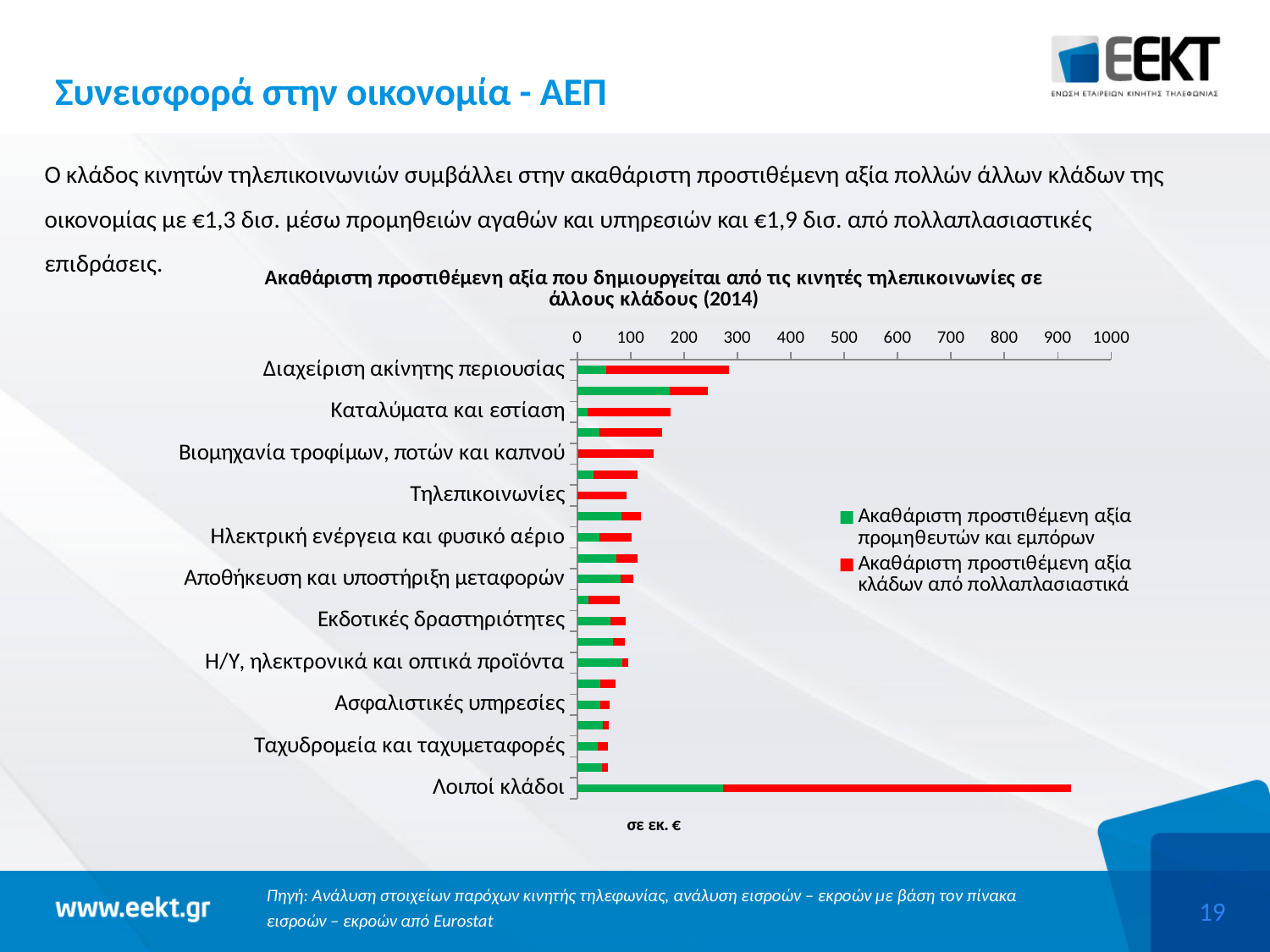
Is the total value for Διαχείριση ακίνητης περιουσίας greater or less than 200? greater Is the total value for Λοιποί κλάδοι greater or less than 800? greater Is the total value for Τηλεπικοινωνίες greater or less than 200? less What kind of chart is shown on the slide? bar chart Which category has the highest total value in the chart? Λοιποί κλάδοι Which year does the chart title refer to? 2014 How many series does the legend of the chart list? 2 Which has the larger total value: Διαχείριση ακίνητης περιουσίας or Καταλύματα και εστίαση? Διαχείριση ακίνητης περιουσίας What unit is stated below the chart's x axis? σε εκ. €